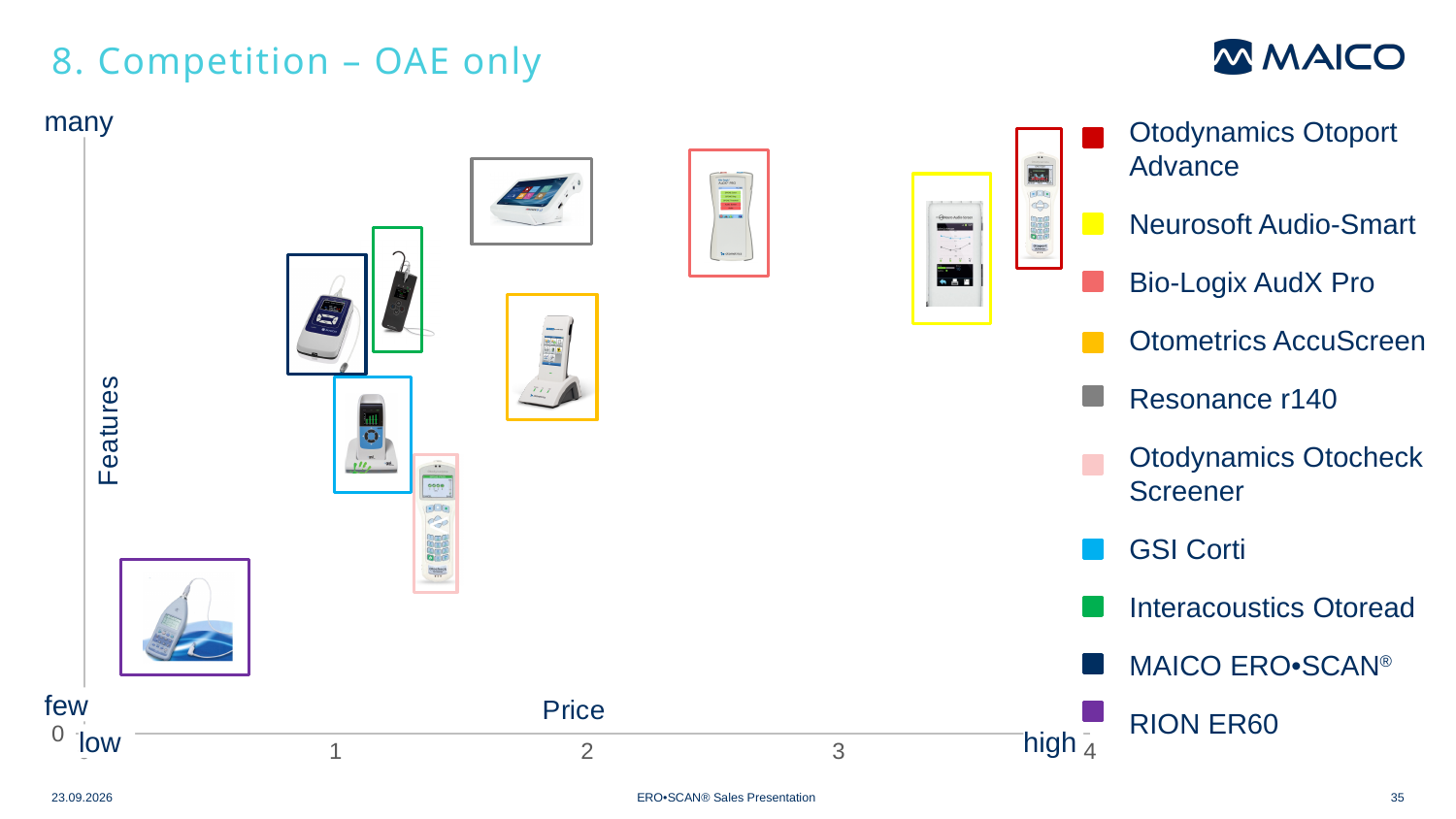
Which is positioned at a higher price, Bio-Logix AudX Pro or Otometrics AccuScreen? Bio-Logix AudX Pro Is the price value for Bio-Logix AudX Pro greater or less than 2? greater Is the price value for RION ER60 greater or less than 1? less Is the price value for Resonance r140 greater or less than 2? less What is the title of the slide's chart? 8. Competition – OAE only What are the labels of the x axis and the y axis? Price and Features What kind of chart is shown on the slide? scatter chart How many products does the legend list? 10 Which product is positioned with the fewest features? RION ER60 Which product is positioned at the highest price? Otodynamics Otoport Advance Which product is positioned at the lowest price? RION ER60